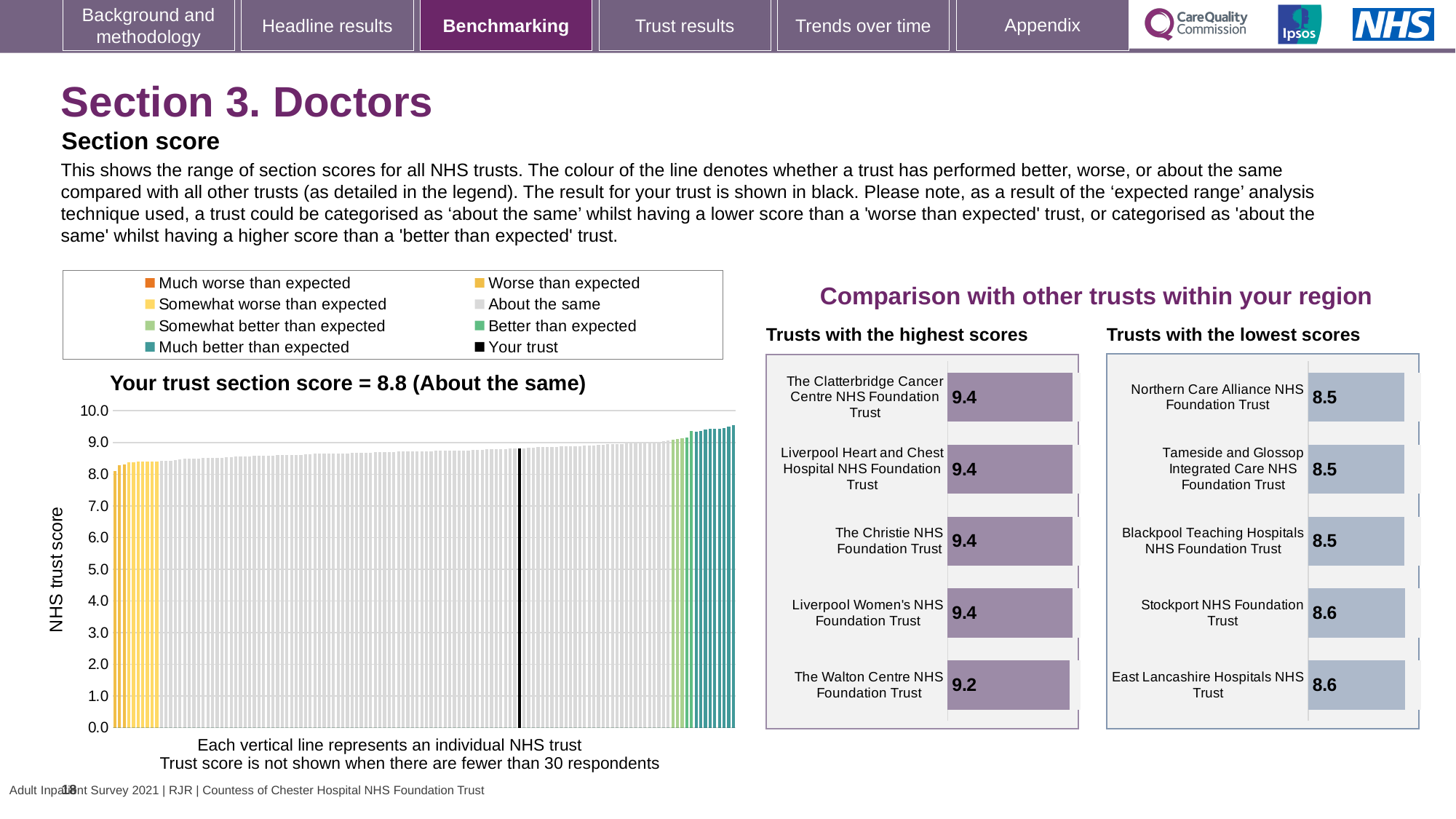
How many trusts are shown in the 'Trusts with the highest scores' chart? 5 What is the section score for your trust shown in the title of the left-hand chart? 8.8 In the 'Trusts with the highest scores' chart, which trust has the lowest score? The Walton Centre NHS Foundation Trust What is the label on the vertical axis of the left-hand chart? NHS trust score In the 'Trusts with the lowest scores' chart, which has the higher score: East Lancashire Hospitals NHS Trust or Blackpool Teaching Hospitals NHS Foundation Trust? East Lancashire Hospitals NHS Trust In the 'Trusts with the lowest scores' chart, what is the difference between the scores for Stockport NHS Foundation Trust and Northern Care Alliance NHS Foundation Trust? 0.1 In the 'Trusts with the highest scores' chart, what is the score for The Walton Centre NHS Foundation Trust? 9.2 How many entries does the legend above the left-hand chart list? 8 In the 'Trusts with the lowest scores' chart, what is the score for Stockport NHS Foundation Trust? 8.6 What kind of chart is the left-hand chart showing the range of section scores for all NHS trusts? bar chart In the left-hand chart, do the trust scores rise or fall from left to right along the x axis? rise In the 'Trusts with the highest scores' chart, what is the score for The Christie NHS Foundation Trust? 9.4